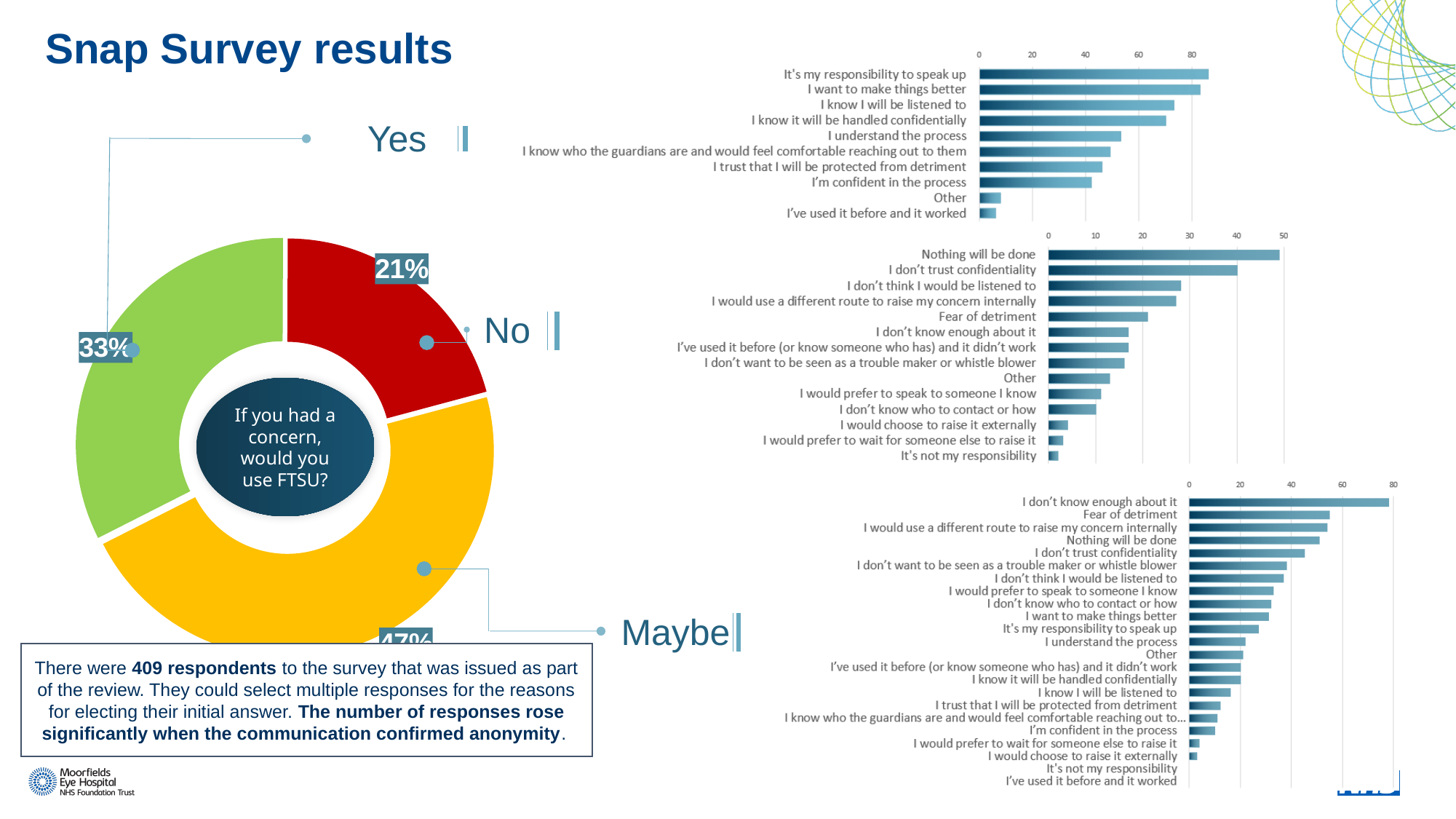
In the middle bar chart on the right, which reason has the highest value? Nothing will be done On the donut chart on the left, which is larger, the Yes share or the No share? Yes On the donut chart on the left, what is the difference between the Yes share and the No share? 12% In the top bar chart on the right, is the value for "I understand the process" greater or less than 40? greater In the top bar chart on the right, which reason has the highest value? It's my responsibility to speak up In the middle bar chart on the right, is the value for "I don't trust confidentiality" greater or less than 30? greater How many slices does the donut chart on the left have? 3 What question is written in the centre of the donut chart on the left? If you had a concern, would you use FTSU? In the bottom bar chart on the right, which reason has the highest value? I don't know enough about it In the top bar chart on the right, which reason has the lowest value? I've used it before and it worked On the donut chart on the left, what share of respondents answered Yes? 33% On the donut chart on the left, what share of respondents answered No? 21%